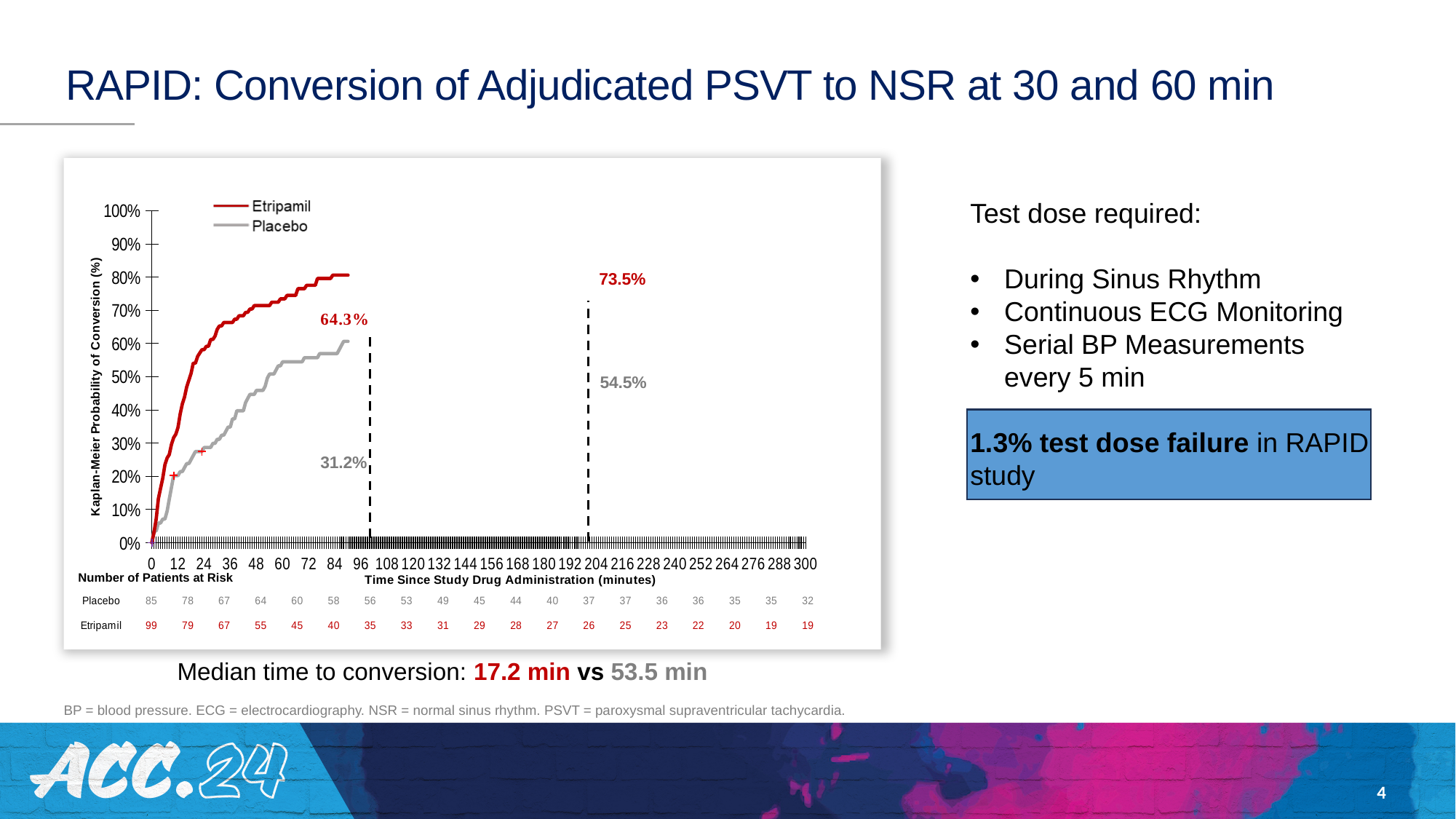
How many series does the chart legend list? 2 In the Number of Patients at Risk table, how many Placebo patients are at risk at 300 minutes? 32 In the Number of Patients at Risk table, how many Etripamil patients are at risk at time 0? 99 What Kaplan-Meier probability of conversion is labelled for Etripamil at the second dashed vertical line? 73.5% Which series has the higher probability of conversion at the second dashed vertical line, Etripamil or Placebo? Etripamil What is the difference between the Etripamil and Placebo labelled values at the second dashed vertical line? 19.0 percentage points Do the Kaplan-Meier curves rise or fall as time since study drug administration increases? rise What Kaplan-Meier probability of conversion is labelled for Placebo at the second dashed vertical line? 54.5% What is the difference between the Etripamil and Placebo labelled values at the first dashed vertical line? 33.1 percentage points What Kaplan-Meier probability of conversion is labelled for Placebo at the first dashed vertical line? 31.2% What kind of chart is shown on the slide? line chart What Kaplan-Meier probability of conversion is labelled for Etripamil at the first dashed vertical line? 64.3%